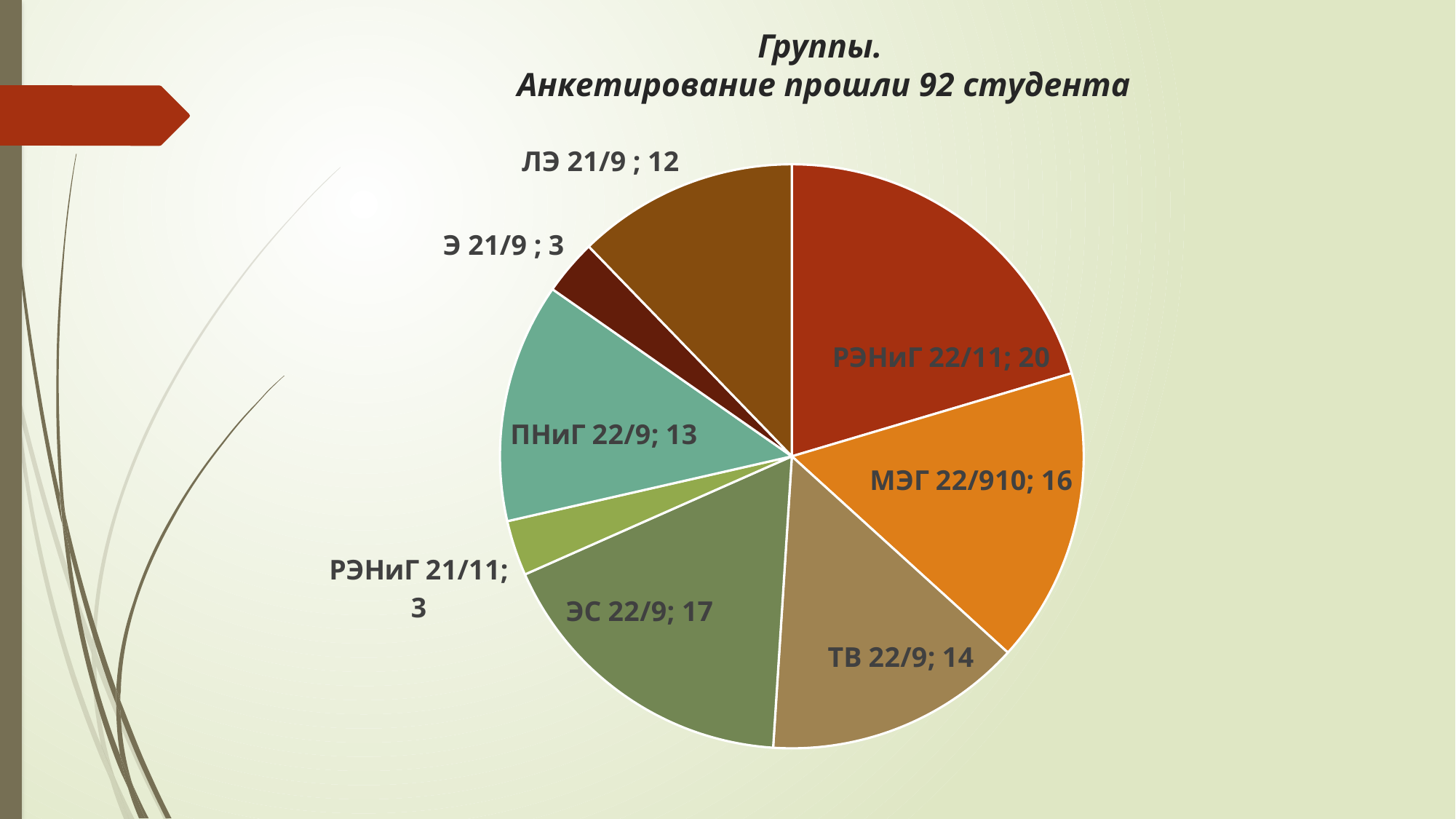
What is the value for ЭС 22/9? 17 What is the value for ПНиГ 22/9? 13 Which is larger, the value for ТВ 22/9 or the value for ПНиГ 22/9? ТВ 22/9 Which group has the largest slice in the pie chart? РЭНиГ 22/11 What is the difference between the values for РЭНиГ 22/11 and ЭС 22/9? 3 According to the chart title, how many students completed the survey? 92 What is the value for РЭНиГ 22/11? 20 What kind of chart is shown on the slide? pie chart What is the value for МЭГ 22/910? 16 What is the value for ЛЭ 21/9? 12 How many slices does the pie chart have? 8 What is the value for ТВ 22/9? 14